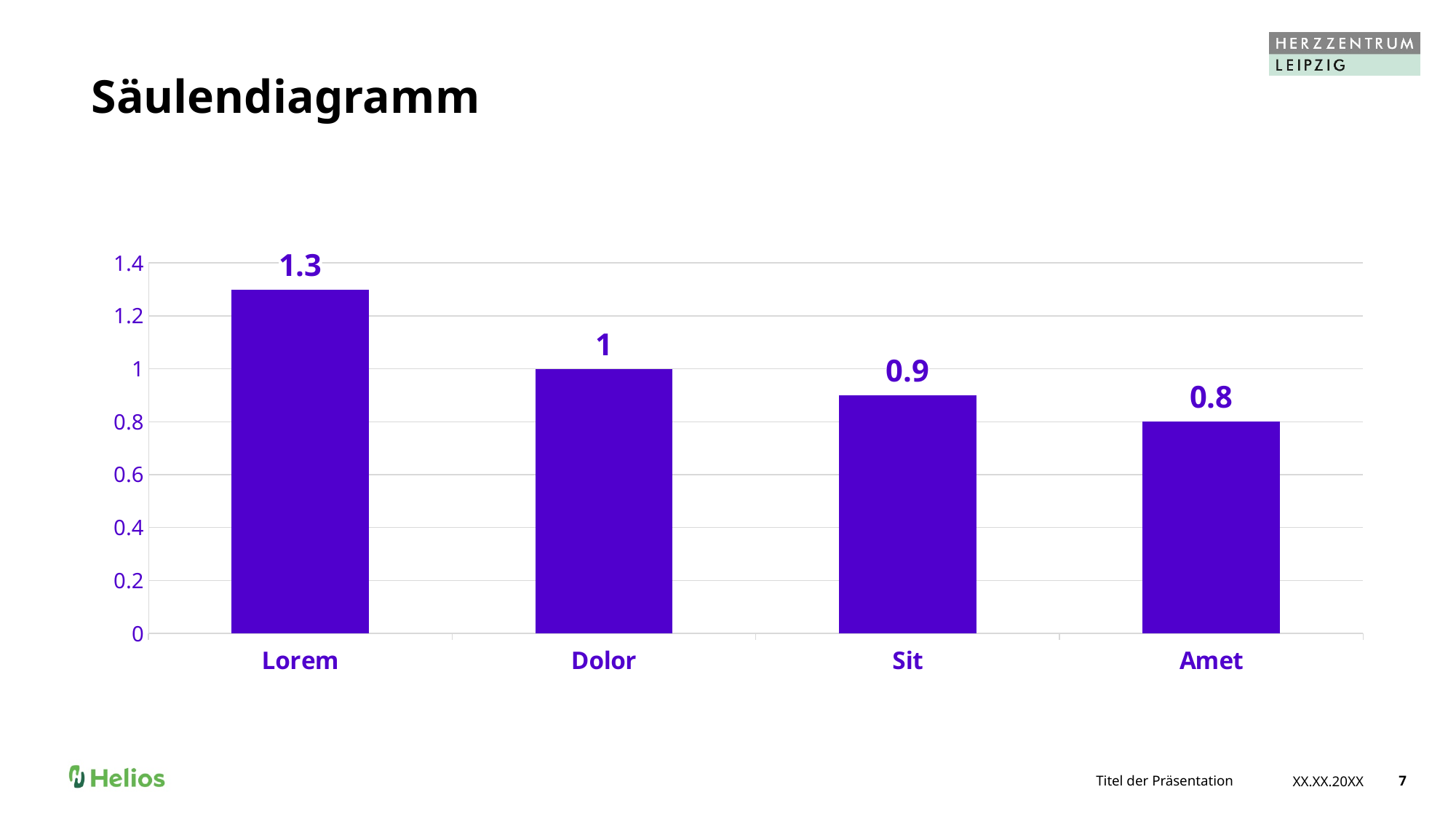
What is the value for Dolor? 1 Do the values rise or fall from left to right along the x axis? fall Which category has the lowest value? Amet What kind of chart is shown on the slide? bar chart Which category has the highest value? Lorem What is the difference between the values for Lorem and Amet? 0.5 What is the value for Amet? 0.8 How many categories are shown on the x axis? 4 What is the value for Lorem? 1.3 Is the value for Lorem greater or less than 1.2? greater Which is larger, the value for Dolor or the value for Sit? Dolor What is the value for Sit? 0.9